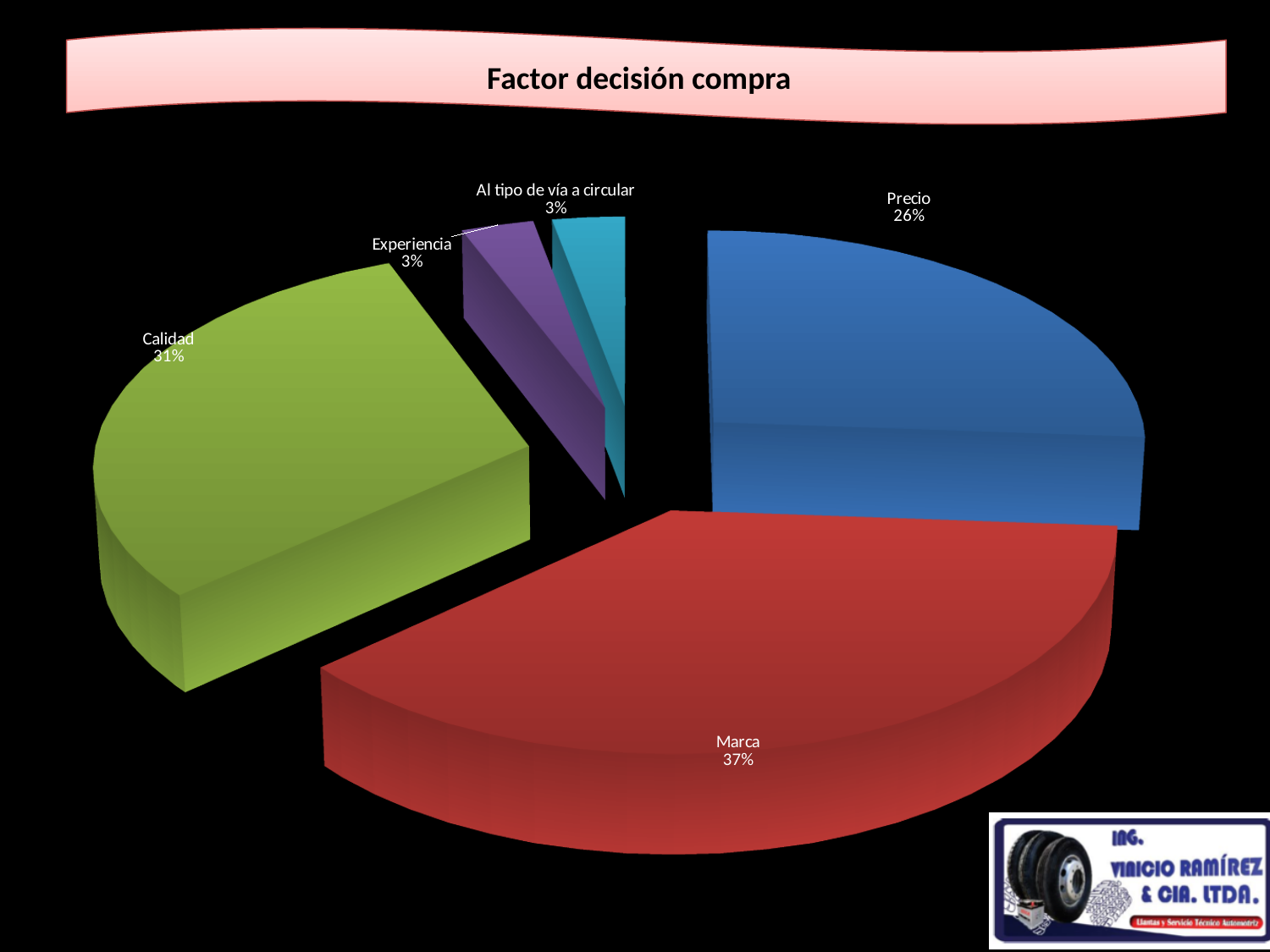
What is the title of the chart? Factor decisión compra What kind of chart is shown on the slide? Pie chart What share of the pie does Precio have? 26% Which is larger, Calidad or Precio? Calidad How many categories are shown in the pie chart? 5 Which category has the largest slice of the pie? Marca What share of the pie does Marca have? 37% What share of the pie does Experiencia have? 3% What is the difference in percentage points between Calidad and Precio? 5 What colour is the Marca slice? Red What is the difference in percentage points between Marca and Precio? 11 What share of the pie does Calidad have? 31%